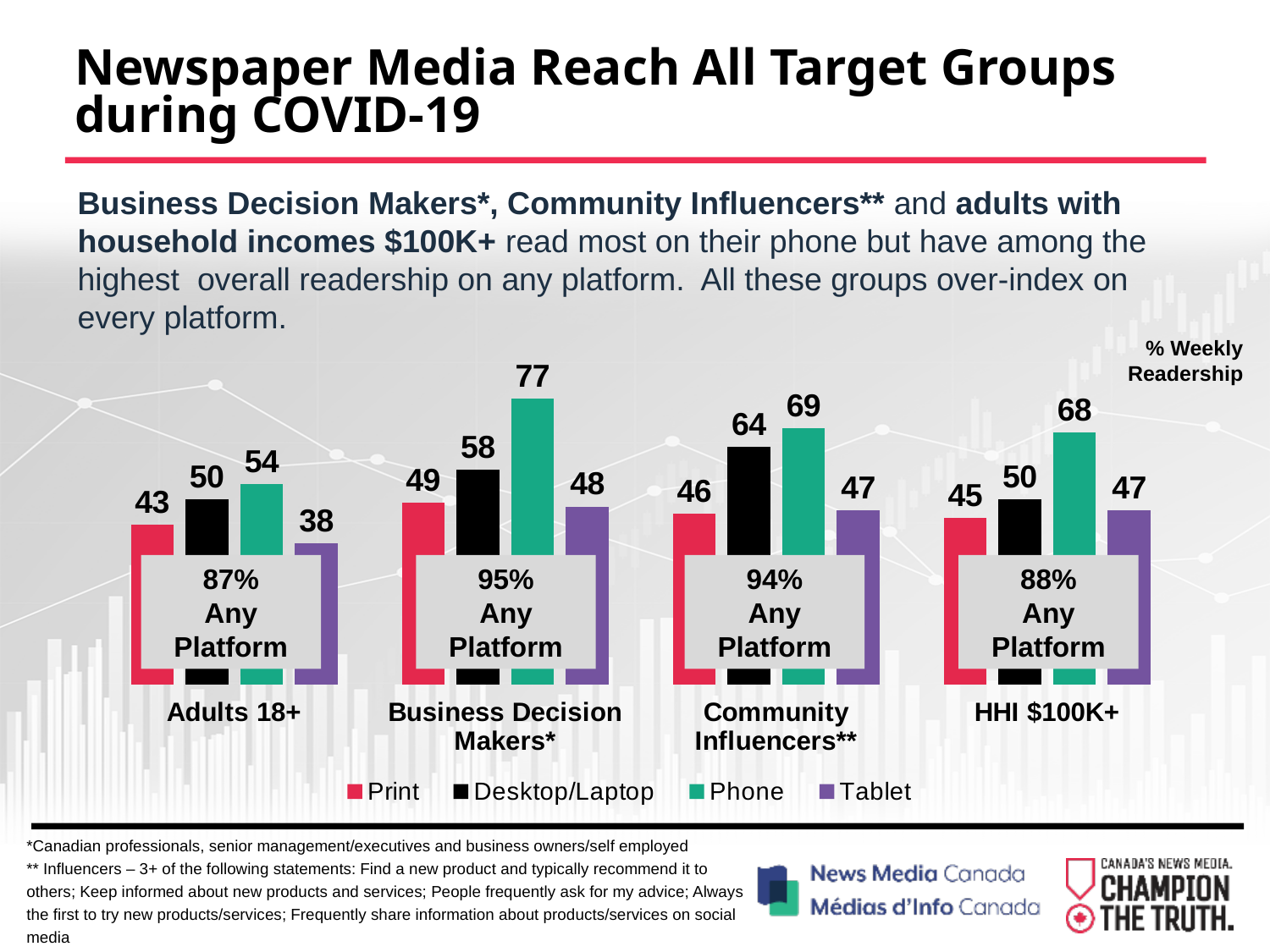
How many series does the legend list? 4 What is the Desktop/Laptop value for Community Influencers**? 64 How many categories are shown on the x axis? 4 Which category has the highest Phone value? Business Decision Makers* What is the difference between the Phone and Print values for Community Influencers**? 23 Which category has the lowest Tablet value? Adults 18+ What is the Print value for HHI $100K+? 45 What kind of chart is shown on the slide? Bar chart What is the Tablet value for Adults 18+? 38 Which is larger for HHI $100K+: the Desktop/Laptop value or the Tablet value? Desktop/Laptop What Any Platform percentage is shown for Business Decision Makers*? 95% What is the Phone value for Business Decision Makers*? 77